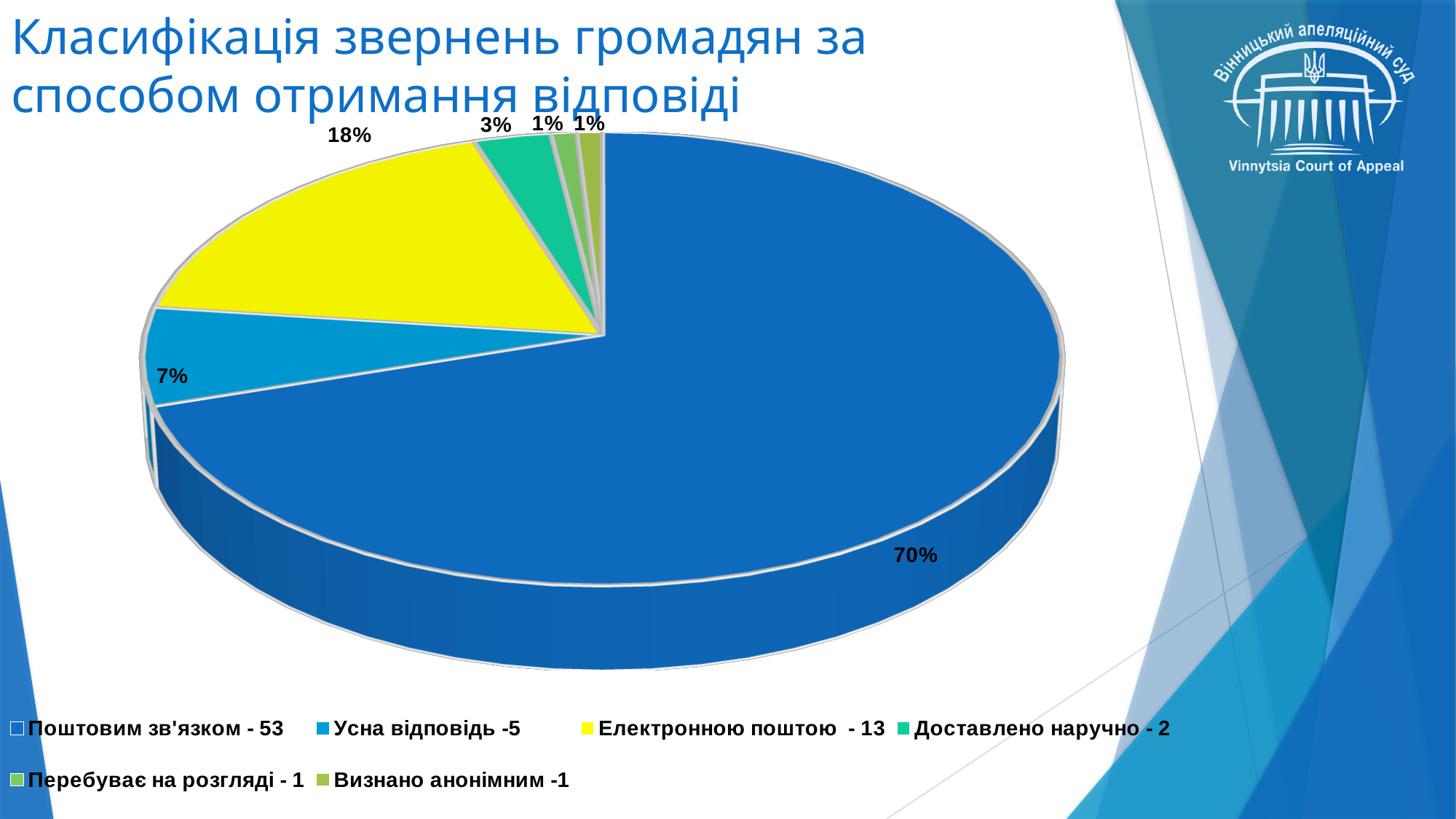
What percentage share does the slice for "Поштовим зв'язком" have? 70% How many categories does the legend list? 6 What percentage share does the slice for "Електронною поштою" have? 18% What is the difference in percentage points between the "Електронною поштою" slice and the "Усна відповідь" slice? 11 Which slice is larger: "Усна відповідь" or "Доставлено наручно"? Усна відповідь According to the legend, how many appeals were answered by "Електронною поштою"? 13 What percentage share does the slice for "Усна відповідь" have? 7% Which category has the largest slice of the pie? Поштовим зв'язком According to the legend, how many appeals were answered by "Поштовим зв'язком"? 53 What kind of chart is shown on the slide? pie chart What colour is the slice for "Електронною поштою"? yellow